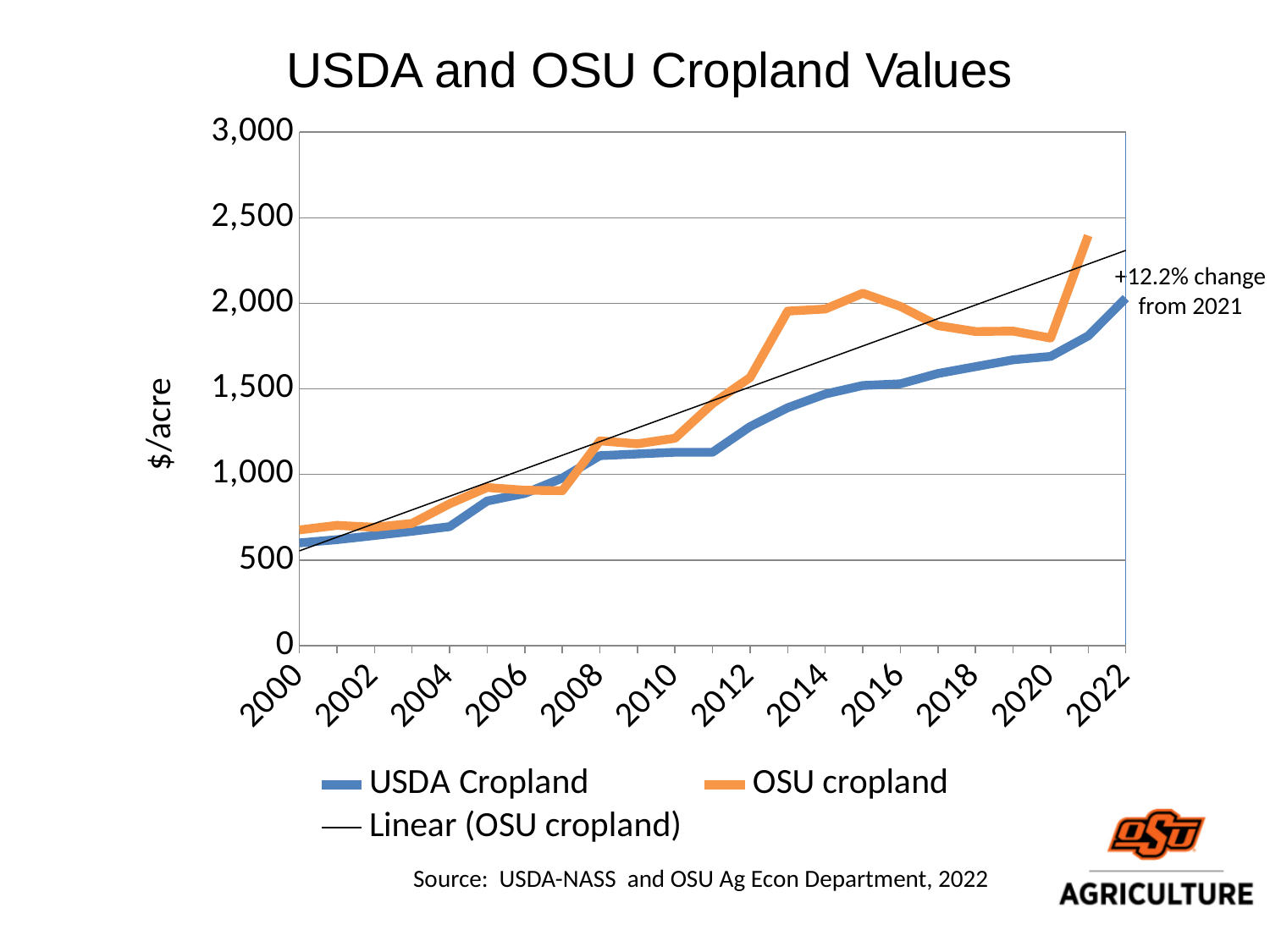
What is the title of the chart? USDA and OSU Cropland Values What kind of chart is shown on the slide? line chart How many entries does the legend list? 3 What percentage change from 2021 is annotated on the chart? +12.2% Is the value for USDA Cropland in 2000 greater or less than 1,000? less What is the label on the vertical axis? $/acre In 2014, which series has the larger value, USDA Cropland or OSU cropland? OSU cropland Does the USDA Cropland series generally rise or fall from 2000 to 2022? rise Which series reaches the highest value shown on the chart? OSU cropland Is the value for OSU cropland in 2021 greater or less than 2,000? greater Is the value for USDA Cropland in 2012 greater or less than 1,000? greater